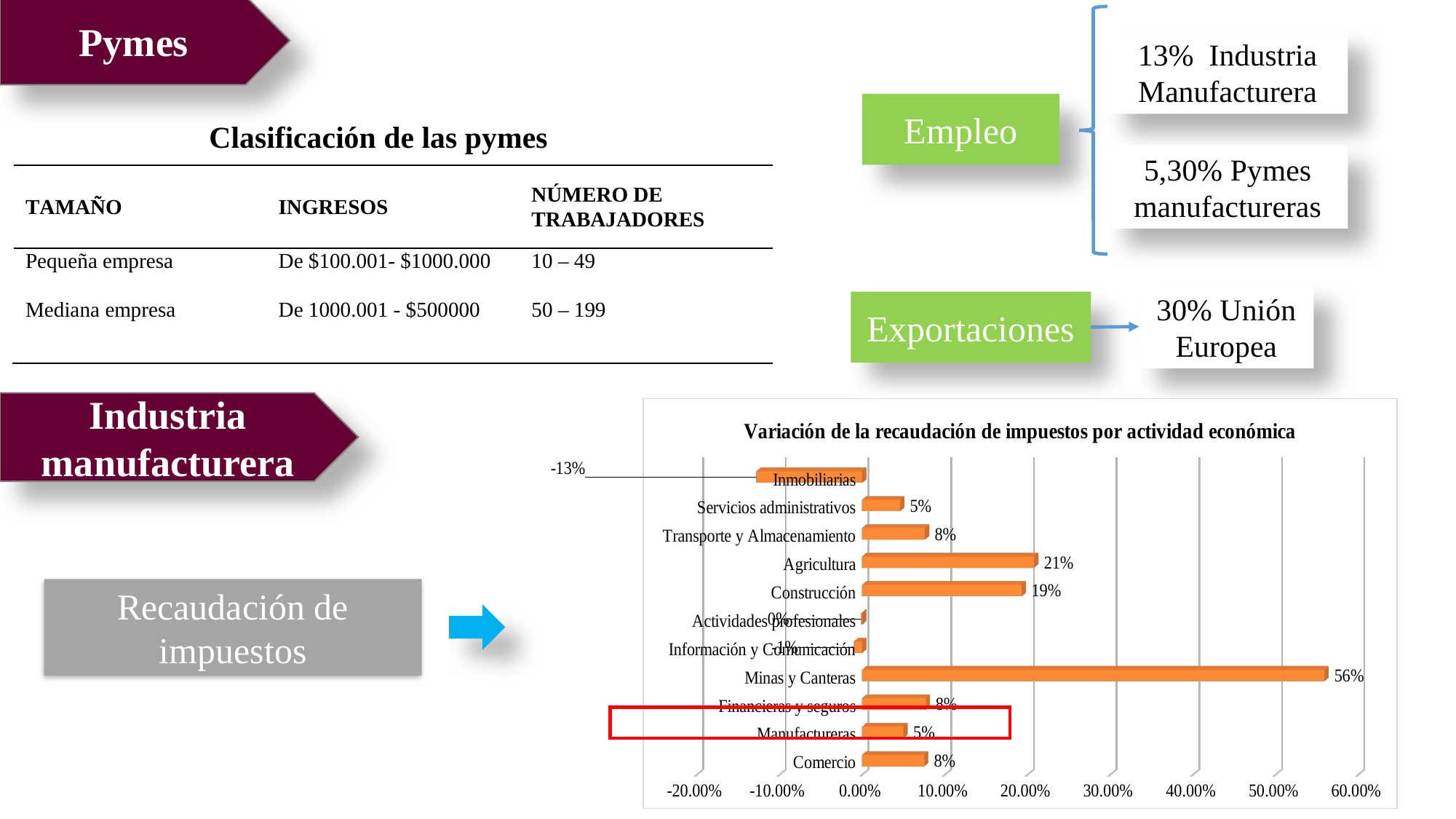
What is the value for Inmobiliarias in the chart 'Variación de la recaudación de impuestos por actividad económica'? -13% How many categories are shown in the chart 'Variación de la recaudación de impuestos por actividad económica'? 11 What is the value for Minas y Canteras in the chart 'Variación de la recaudación de impuestos por actividad económica'? 56% Which category has the highest value in the chart 'Variación de la recaudación de impuestos por actividad económica'? Minas y Canteras What is the value for Manufactureras in the chart 'Variación de la recaudación de impuestos por actividad económica'? 5% What is the title of the chart on the slide? Variación de la recaudación de impuestos por actividad económica Which category has the lowest value in the chart 'Variación de la recaudación de impuestos por actividad económica'? Inmobiliarias What kind of chart is 'Variación de la recaudación de impuestos por actividad económica'? bar chart In the chart 'Variación de la recaudación de impuestos por actividad económica', what is the difference between the values for Agricultura and Construcción? 2% In the chart 'Variación de la recaudación de impuestos por actividad económica', is the value for Minas y Canteras greater or less than 50.00%? greater In the chart 'Variación de la recaudación de impuestos por actividad económica', which is larger: the value for Construcción or the value for Comercio? Construcción What is the value for Agricultura in the chart 'Variación de la recaudación de impuestos por actividad económica'? 21%